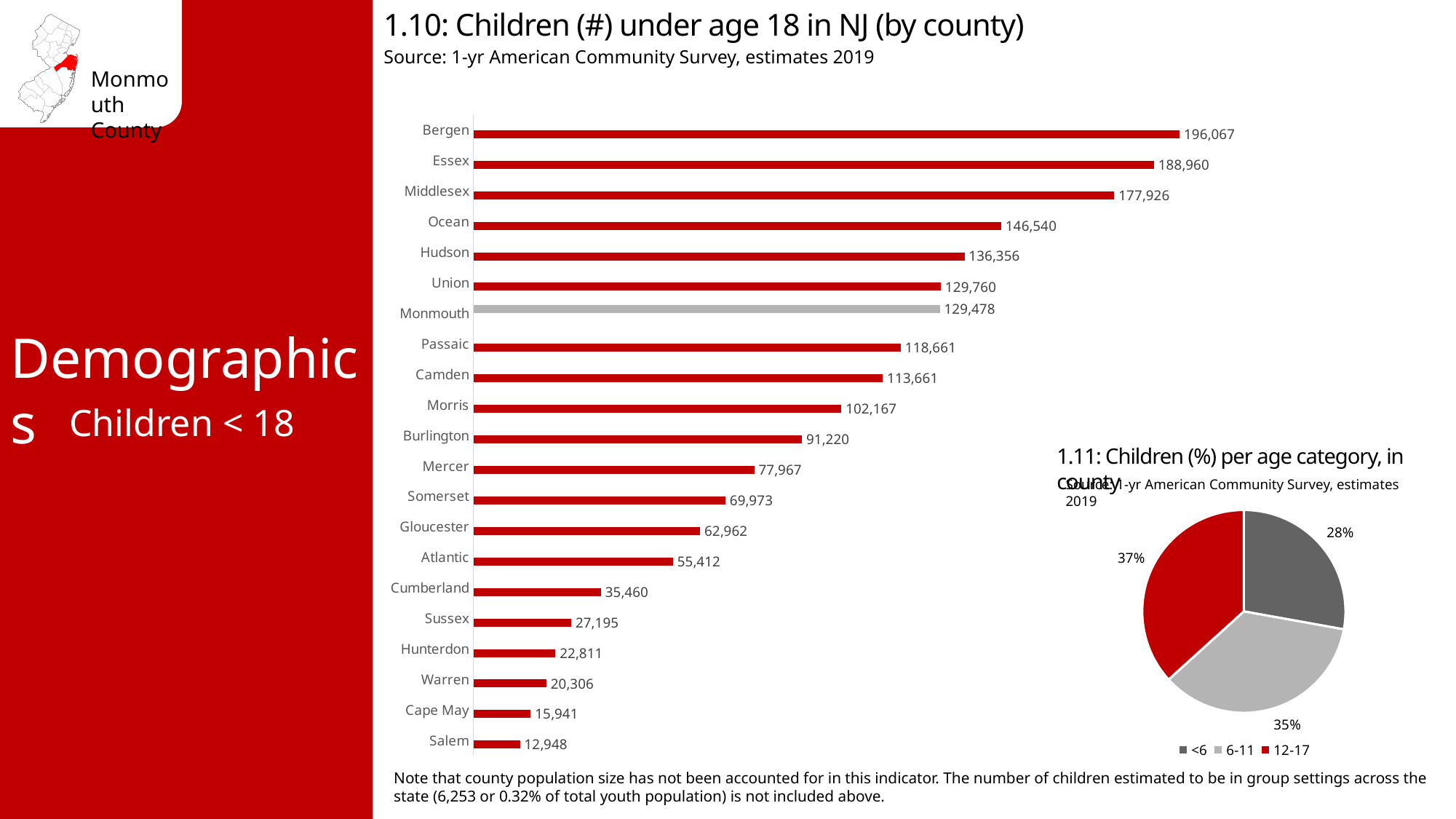
How many age categories does the legend of chart 1.11 list? 3 In chart 1.10, which county has more children under 18, Ocean or Hudson? Ocean In chart 1.10, which county's bar is coloured grey instead of red? Monmouth In chart 1.10, what is the difference between the values for Bergen and Essex? 7,107 In chart 1.10, which county has the highest number of children under age 18? Bergen What kind of chart is chart 1.10? Bar chart In chart 1.10, which county has the lowest number of children under age 18? Salem In chart 1.10, what is the value for Cape May? 15,941 In chart 1.10, how many children under age 18 are in Monmouth County? 129,478 In chart 1.11, what share of children are in the 12-17 age category? 37% In chart 1.10, how many counties are shown? 21 In chart 1.11, what share of children are under age 6? 28%